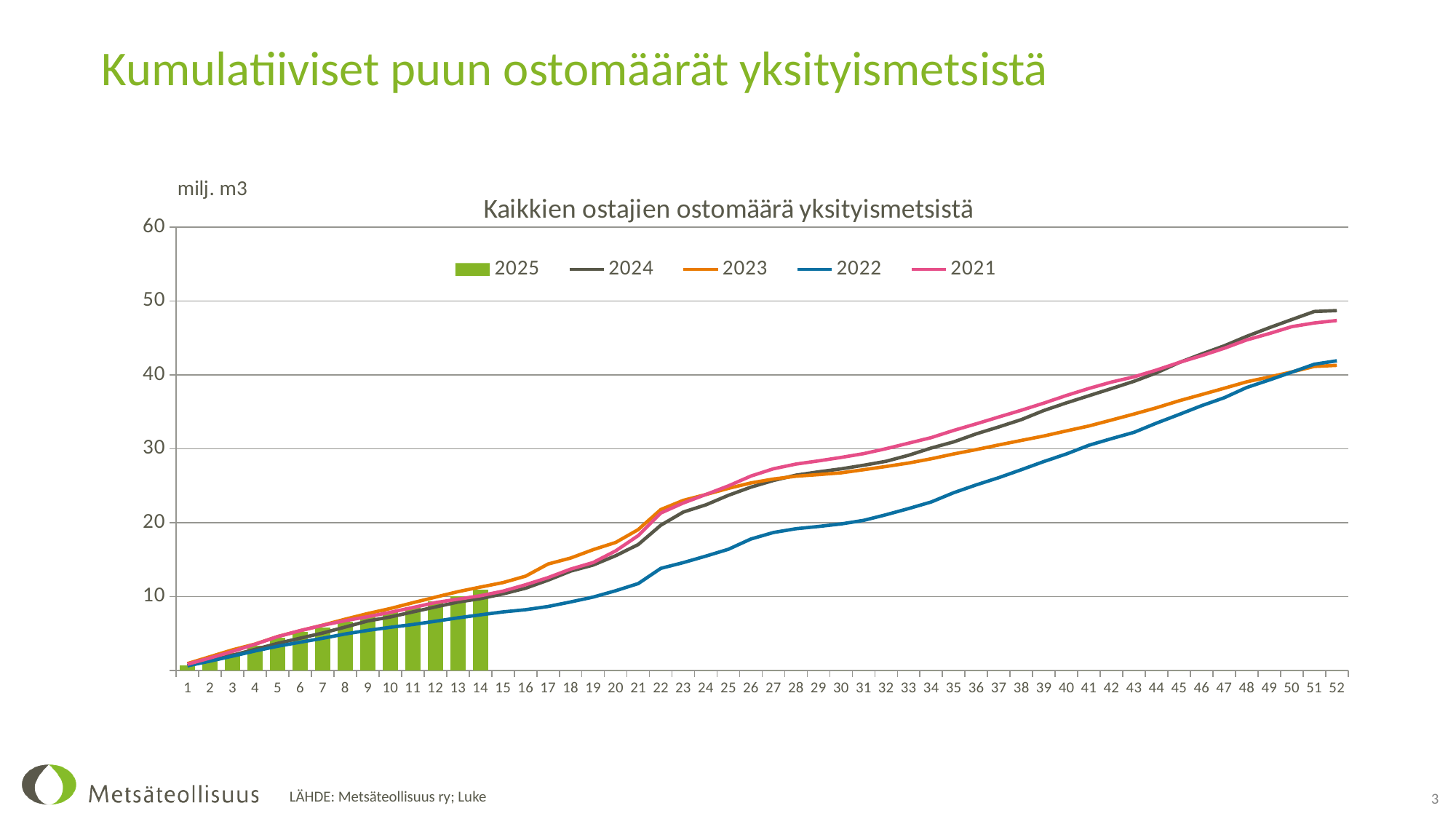
At week 52, which is larger: the value for 2024 or the value for 2022? 2024 How many weeks are shown on the x axis? 52 How many series does the legend list? 5 At week 30, which is larger: the value for 2023 or the value for 2022? 2023 Is the value for 2024 at week 52 greater or less than 40? greater What kind of chart is shown on the slide? A combined bar and line chart Do the values of the 2024 line rise or fall along the x axis? Rise Is the value for 2025 at week 14 greater or less than 5? greater For how many weeks are bars plotted for the 2025 series? 14 What is the title of the chart? Kaikkien ostajien ostomäärä yksityismetsistä Which series is drawn as bars rather than a line? 2025 Is the value for 2022 at week 26 greater or less than 20? less